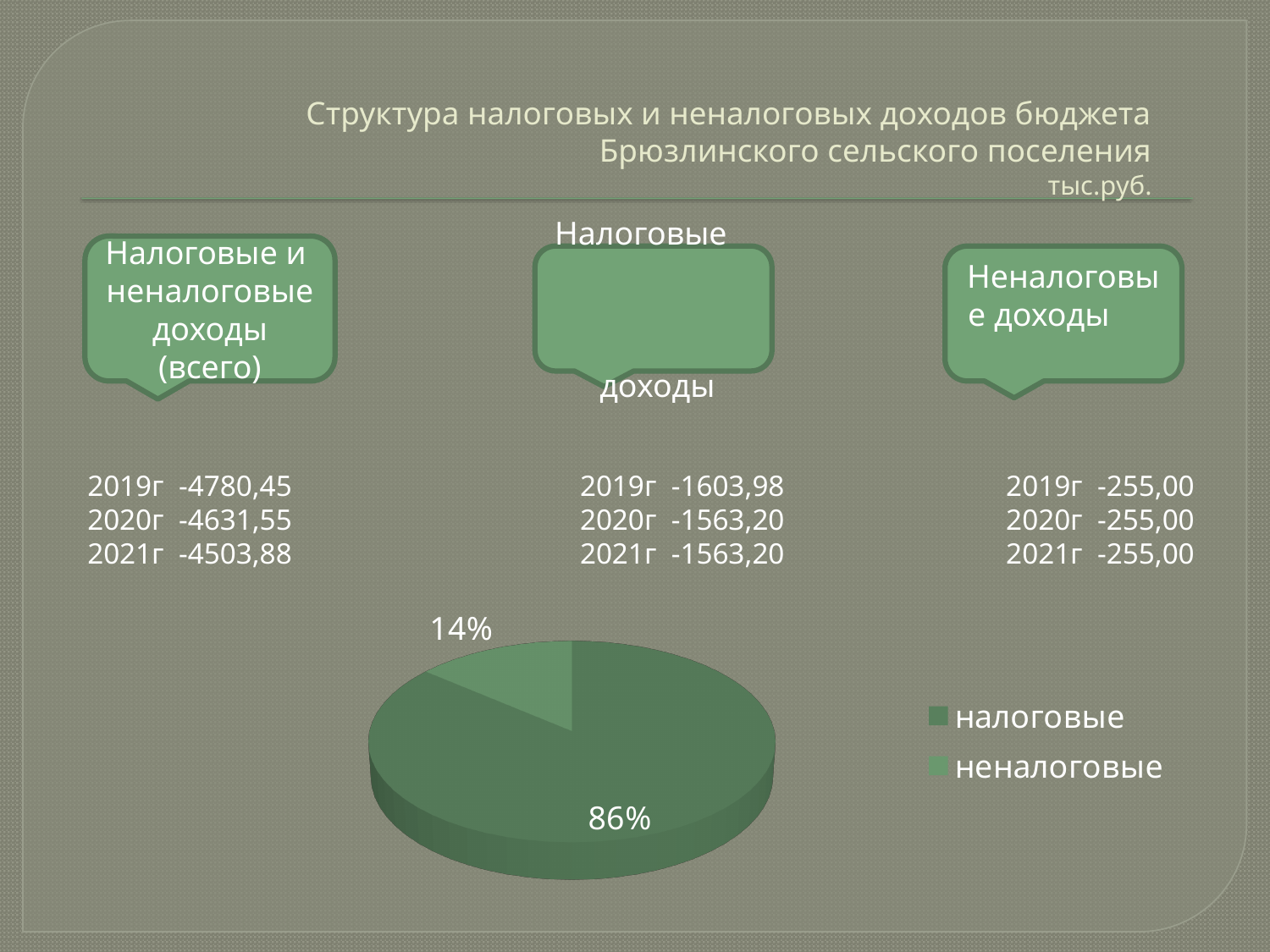
Which legend entry is shown in the lighter green colour? неналоговые Which slice of the pie chart is the largest? налоговые Which legend entry is listed first in the pie chart's legend? налоговые Is the share of the "неналоговые" slice greater or less than 50%? less How many slices does the pie chart have? 2 How many entries does the legend of the pie chart list? 2 Which is larger in the pie chart, "налоговые" or "неналоговые"? налоговые What share of the pie does the "налоговые" slice represent? 86% What share of the pie does the "неналоговые" slice represent? 14% What is the difference in percentage points between the "налоговые" and "неналоговые" slices? 72 Which slice of the pie chart is the smallest? неналоговые What kind of chart is shown on the slide? pie chart